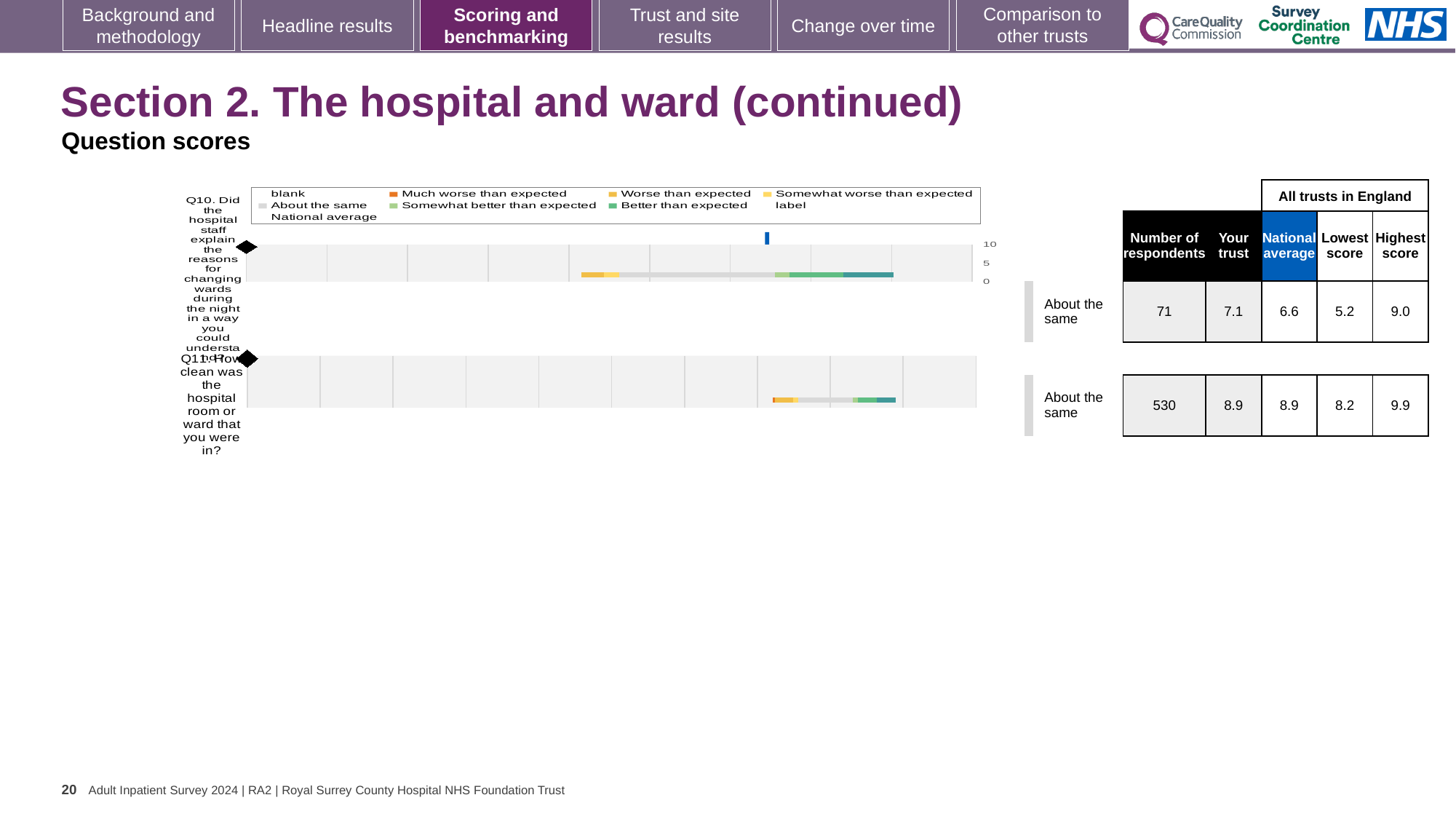
For Q10, which is larger: the 'Your trust' score or the national average? Your trust How many survey questions are plotted on this slide? 2 For Q11, what is the difference between the highest score (9.9) and the lowest score (8.2)? 1.7 For Q11, what is the lowest score among all trusts in England? 8.2 For Q10, what is the highest score among all trusts in England? 9.0 For Q10 (explaining reasons for changing wards during the night), how many respondents are shown in the table? 71 What kind of chart is used to show the question scores? Bar chart For Q10, what is the difference between the highest score (9.0) and the lowest score (5.2)? 3.8 For Q11 (how clean was the hospital room or ward), how many respondents are shown? 530 What benchmark category is shown for Q11? About the same For Q10, what is the 'Your trust' score? 7.1 For Q10, what is the national average score? 6.6